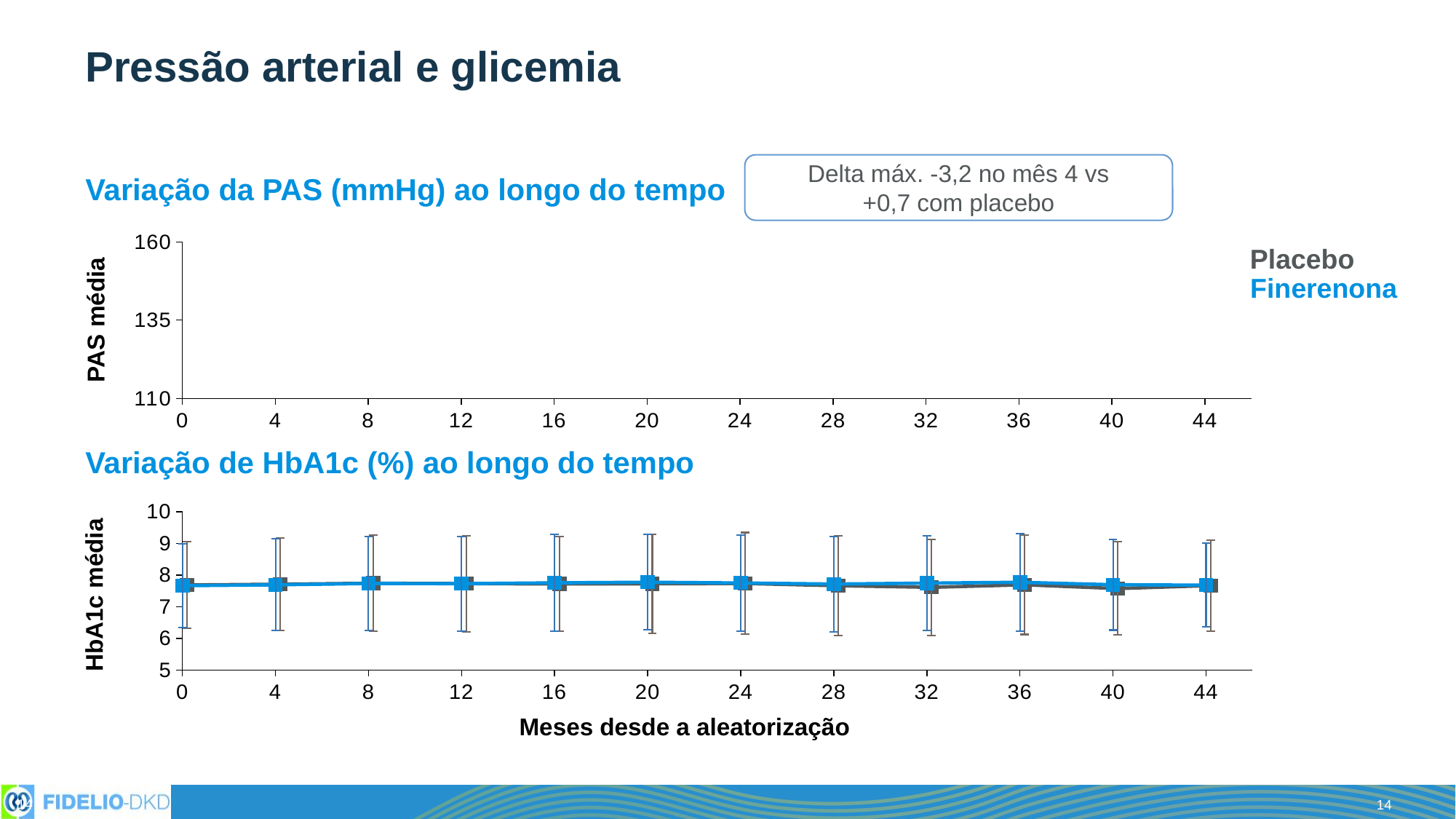
In the 'Variação de HbA1c (%) ao longo do tempo' chart, do the HbA1c values rise, fall, or stay roughly flat from month 0 to month 44? stay roughly flat What kind of chart is the 'Variação de HbA1c (%) ao longo do tempo' chart? line chart Which series is shown in blue in the charts on the slide? Finerenona In the 'Variação de HbA1c (%) ao longo do tempo' chart, is the Placebo value at month 44 greater or less than 9? less In the 'Variação de HbA1c (%) ao longo do tempo' chart, how many time points are plotted along the x axis? 12 What is the highest value shown on the y axis of the 'Variação da PAS (mmHg) ao longo do tempo' chart? 160 What is the lowest value shown on the y axis of the 'Variação de HbA1c (%) ao longo do tempo' chart? 5 How many series does the legend list for the charts on the slide? 2 In the 'Variação de HbA1c (%) ao longo do tempo' chart, is the Finerenona value at month 20 greater or less than 6? greater In the 'Variação de HbA1c (%) ao longo do tempo' chart, is the Finerenona value at month 0 greater or less than 7? greater What is the x-axis label shared by the charts on the slide? Meses desde a aleatorização What is the last month shown on the x axis of the 'Variação de HbA1c (%) ao longo do tempo' chart? 44